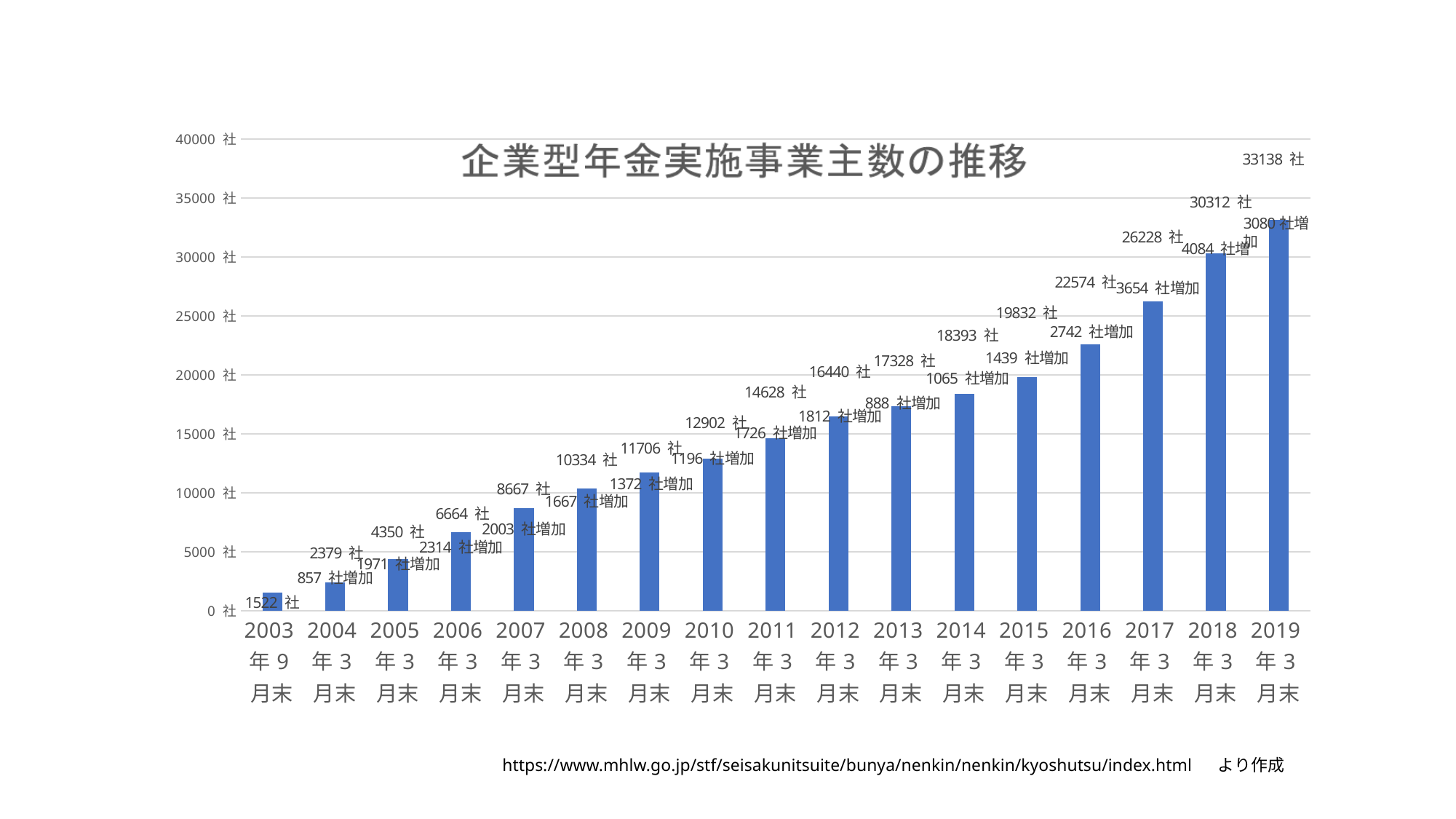
Which time point has the highest value? 2019年3月末 What is the title of the chart? 企業型年金実施事業主数の推移 Which time point has the lowest value? 2003年9月末 Do the values rise or fall from 2003年9月末 to 2019年3月末? rise What is the value for 2011年3月末? 14628 社 How many bars (time points) are plotted in the chart? 17 Which is larger, the value for 2010年3月末 or the value for 2012年3月末? 2012年3月末 Is the value for 2016年3月末 greater or less than 20000 社? greater What is the difference between the values for 2018年3月末 and 2017年3月末? 4084 社 What type of chart is shown on the slide? bar chart What is the value for 2003年9月末? 1522 社 What is the value for 2019年3月末? 33138 社